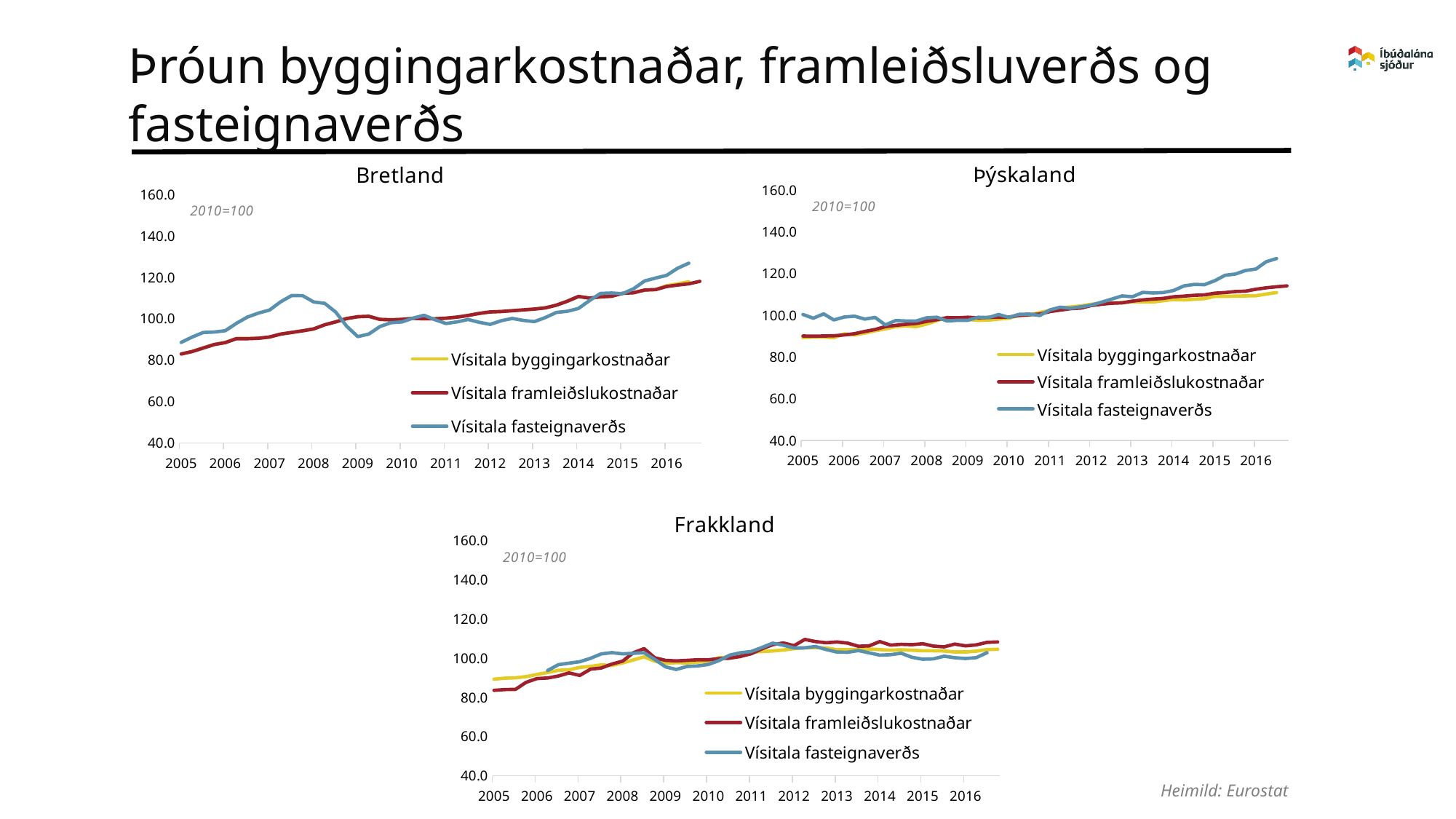
How many year labels are shown on the x axis of the Frakkland chart? 12 In the Þýskaland chart, which series is higher at the end of 2016: Vísitala fasteignaverðs or Vísitala byggingarkostnaðar? Vísitala fasteignaverðs In the Þýskaland chart, is the value of Vísitala fasteignaverðs at the end of 2016 greater or less than 120? greater What base year note is printed on each of the three charts? 2010=100 In the Bretland chart, is the value of Vísitala fasteignaverðs at the end of 2016 greater or less than 120? greater In the Bretland chart, which series is higher at the end of 2016: Vísitala fasteignaverðs or Vísitala framleiðslukostnaðar? Vísitala fasteignaverðs In the Þýskaland chart, does Vísitala fasteignaverðs rise or fall overall from 2005 to 2016? rise In the Bretland chart, does Vísitala framleiðslukostnaðar rise or fall overall from 2005 to 2016? rise In the Frakkland chart, is the value of Vísitala framleiðslukostnaðar at the start of 2005 greater or less than 100? less How many series does the legend of the Þýskaland chart list? 3 What kind of chart is the Bretland chart? line chart